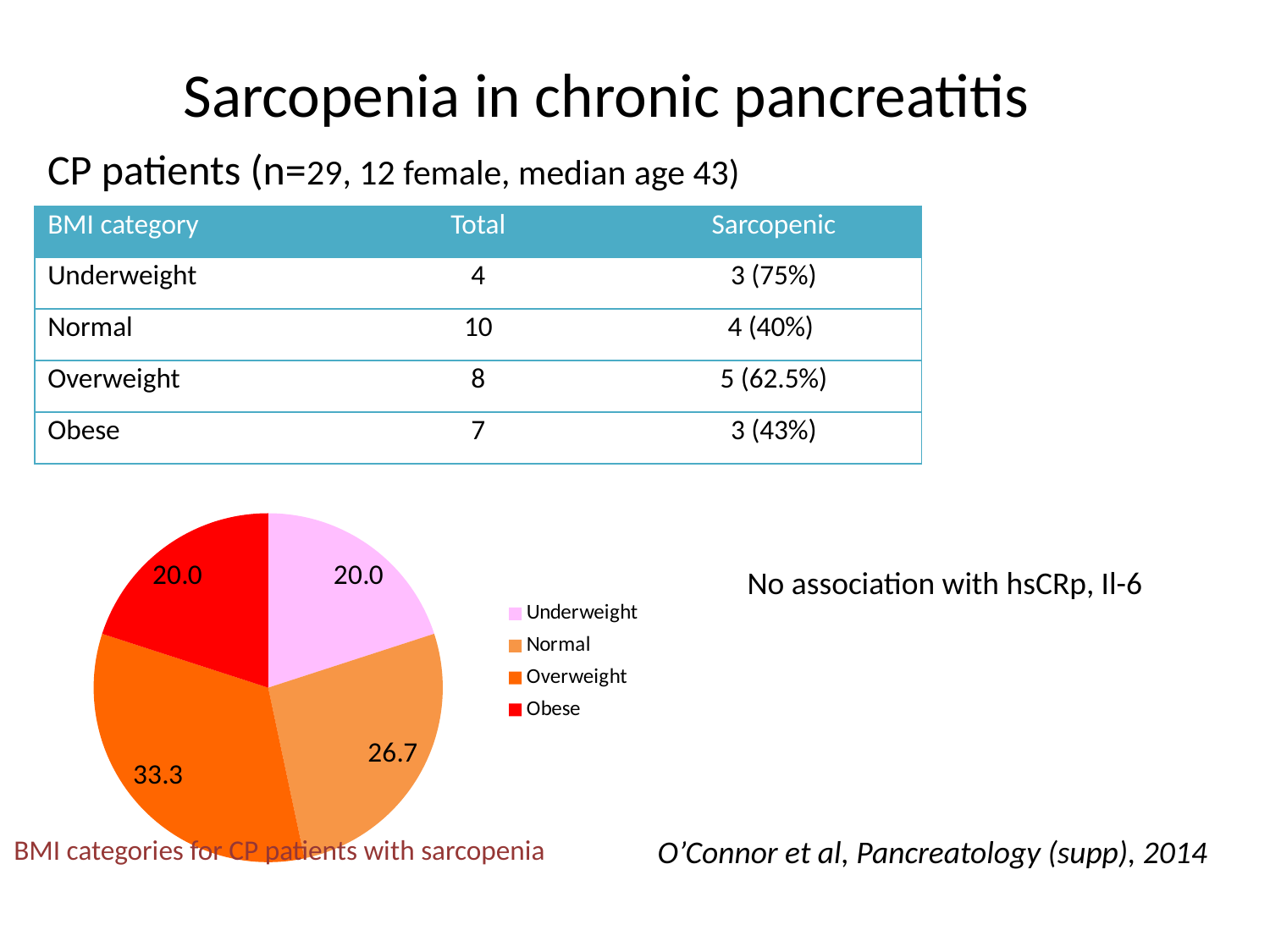
What value is shown for the Normal slice of the pie chart? 26.7 What value is shown for the Obese slice of the pie chart? 20.0 Which slice is larger in the pie chart, Normal or Overweight? Overweight Which BMI category has the largest slice in the pie chart? Overweight What value is shown for the Underweight slice of the pie chart? 20.0 What is the difference between the Overweight and Normal values in the pie chart? 6.6 Which slice is larger in the pie chart, Normal or Obese? Normal What colour is the Obese slice in the pie chart? Red How many slices does the pie chart have? 4 What kind of chart is shown on the slide? Pie chart How many entries does the pie chart's legend list? 4 What value is shown for the Overweight slice of the pie chart? 33.3